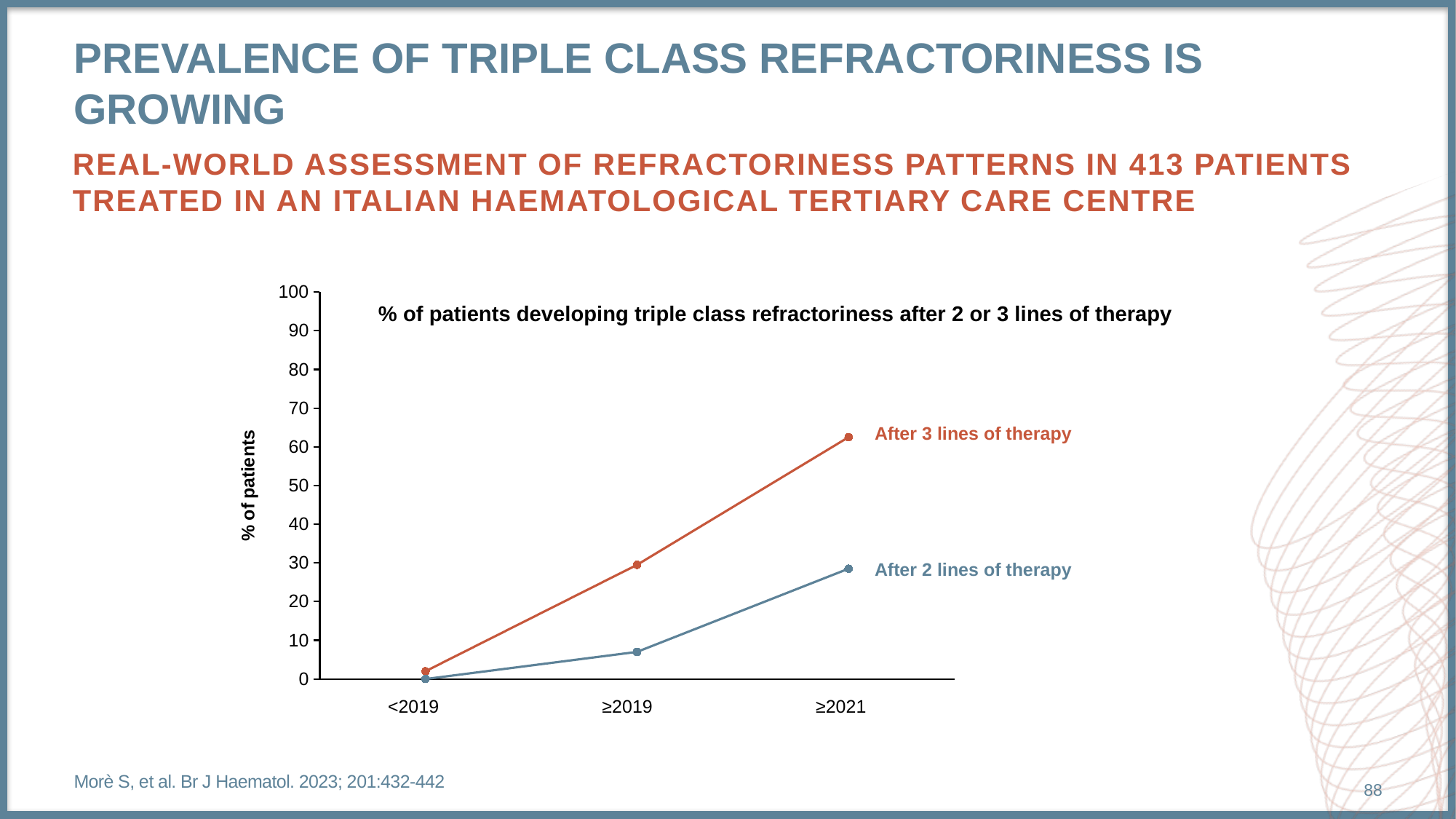
What kind of chart is shown on the slide? Line chart What is the title of the chart? % of patients developing triple class refractoriness after 2 or 3 lines of therapy Is the value for 'After 3 lines of therapy' at ≥2021 greater or less than 50? greater Do the values for 'After 3 lines of therapy' rise or fall from <2019 to ≥2021? Rise In which period is the value for 'After 2 lines of therapy' lowest? <2019 Do the values for 'After 2 lines of therapy' rise or fall across the x axis? Rise What is the label of the y axis? % of patients How many series are plotted on the chart? 2 At ≥2021, which series has the larger value: 'After 3 lines of therapy' or 'After 2 lines of therapy'? After 3 lines of therapy In which period is the value for 'After 3 lines of therapy' highest? ≥2021 How many time-period categories are shown on the x axis? 3 Is the value for 'After 2 lines of therapy' at ≥2019 greater or less than 10? less